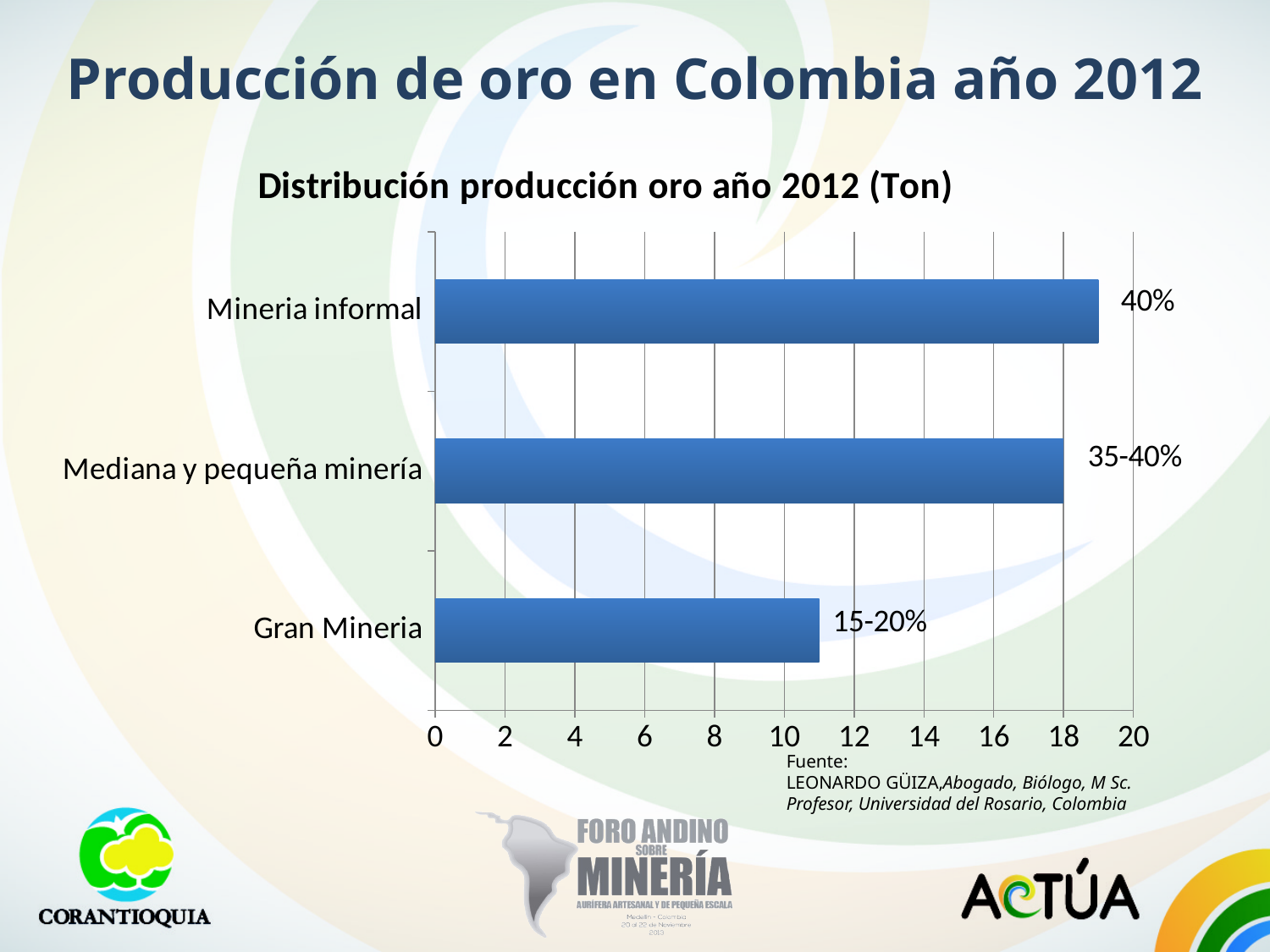
Which category has the shortest bar in the chart? Gran Mineria What label is printed next to the bar for Mineria informal? 40% What kind of chart is shown on the slide? bar chart How many categories are plotted in the chart? 3 Which bar is longer, Gran Mineria or Mediana y pequeña minería? Mediana y pequeña minería What label is printed next to the bar for Gran Mineria? 15-20% Is the bar for Gran Mineria greater or less than 12? less Which category has the longest bar in the chart? Mineria informal Is the bar for Gran Mineria greater or less than 10? greater What is the title of the chart? Distribución producción oro año 2012 (Ton) Is the bar for Mineria informal greater or less than 18? greater What label is printed next to the bar for Mediana y pequeña minería? 35-40%